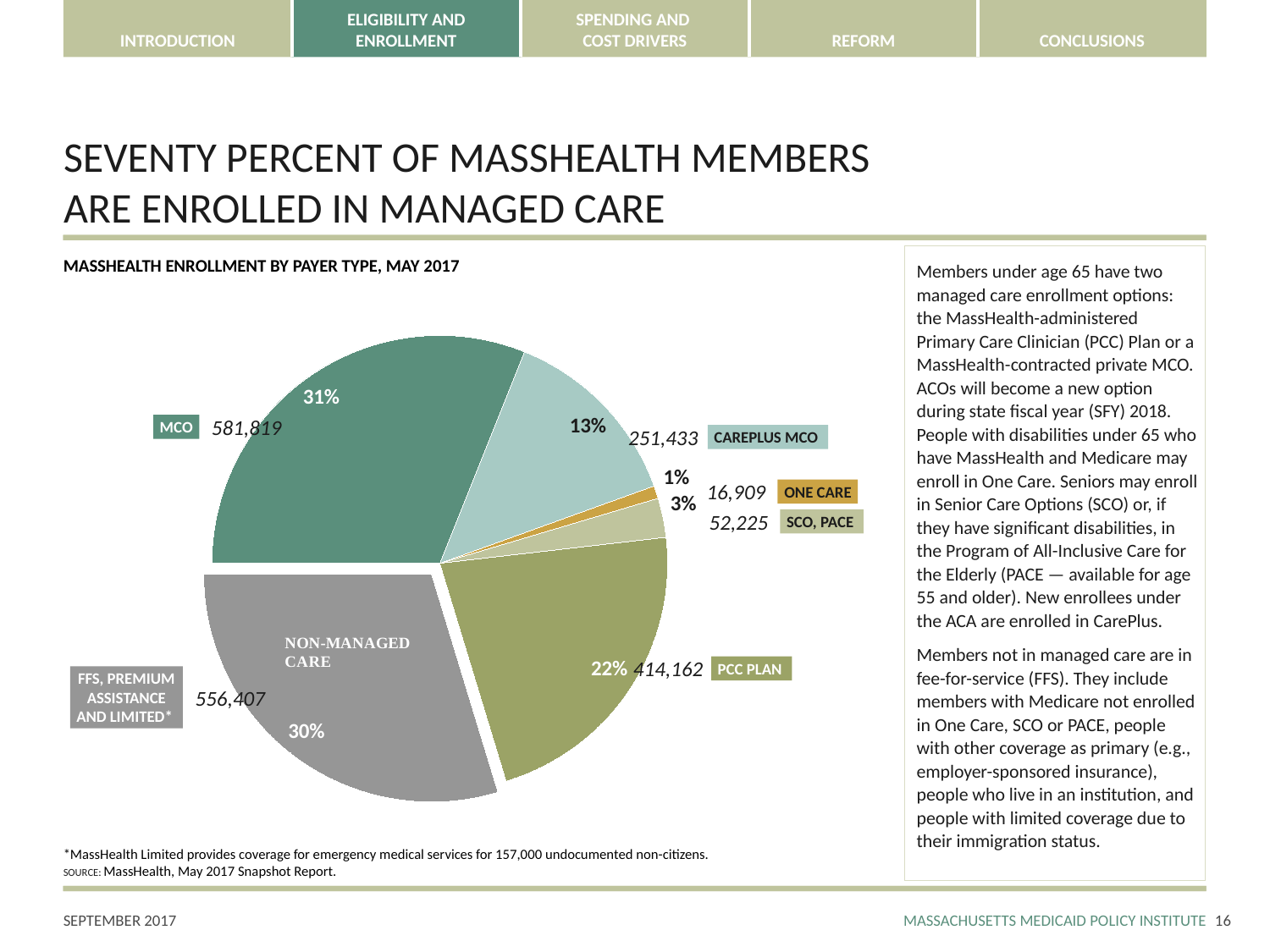
What is the enrollment value for MCO? 581,819 Which payer type has the largest slice? MCO What is the enrollment value for the PCC Plan? 414,162 Which payer type has the smallest slice? One Care What is the difference in enrollment between MCO and the PCC Plan? 167,657 What share of the pie does FFS, Premium Assistance and Limited represent? 30% How many slices does the pie chart have? 6 What kind of chart is shown on the slide? pie chart What share of the pie does CarePlus MCO represent? 13% Which has higher enrollment, SCO, PACE or CarePlus MCO? CarePlus MCO What is the title of the chart? MassHealth Enrollment by Payer Type, May 2017 What is the enrollment value for One Care? 16,909